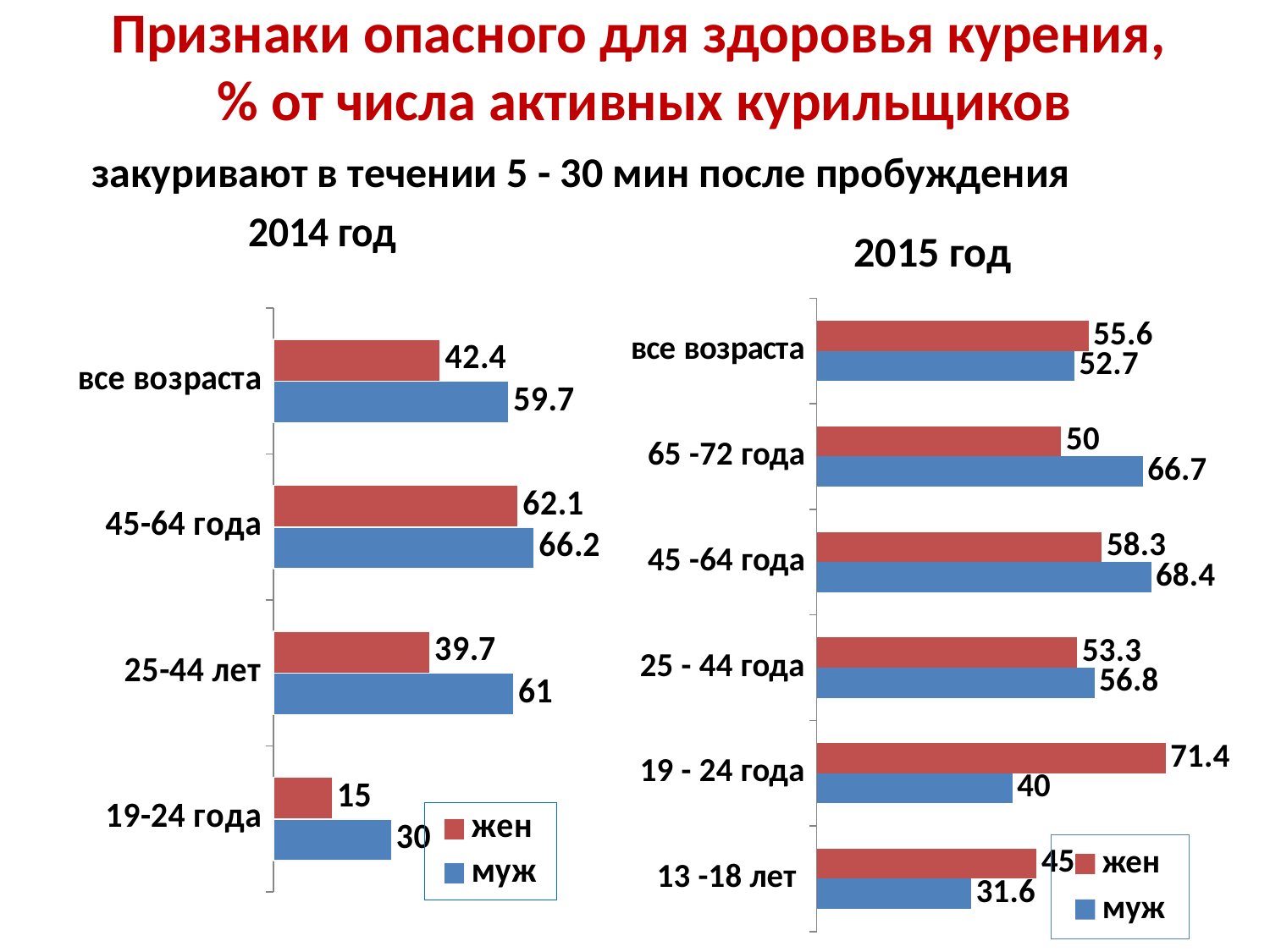
What type of chart is the 2014 год chart? bar chart In the 2015 год chart, which category has the lowest value for муж? 13 -18 лет In the 2014 год chart, what is the difference between the муж and жен values for все возраста? 17.3 In the 2014 год chart, which category has the highest value for жен? 45-64 года In the 2015 год chart, what is the value for муж in the 13 -18 лет category? 31.6 In the 2015 год chart, which is larger for все возраста: жен or муж? жен In the 2014 год chart, what is the value for жен in the 19-24 года category? 15 In the 2015 год chart, what is the value for жен in the 19 - 24 года category? 71.4 In the 2014 год chart, what is the value for муж in the 45-64 года category? 66.2 In the 2015 год chart, what is the difference between the муж and жен values for 65 -72 года? 16.7 How many series does the legend of the 2014 год chart list? 2 How many age categories does the 2015 год chart show? 6